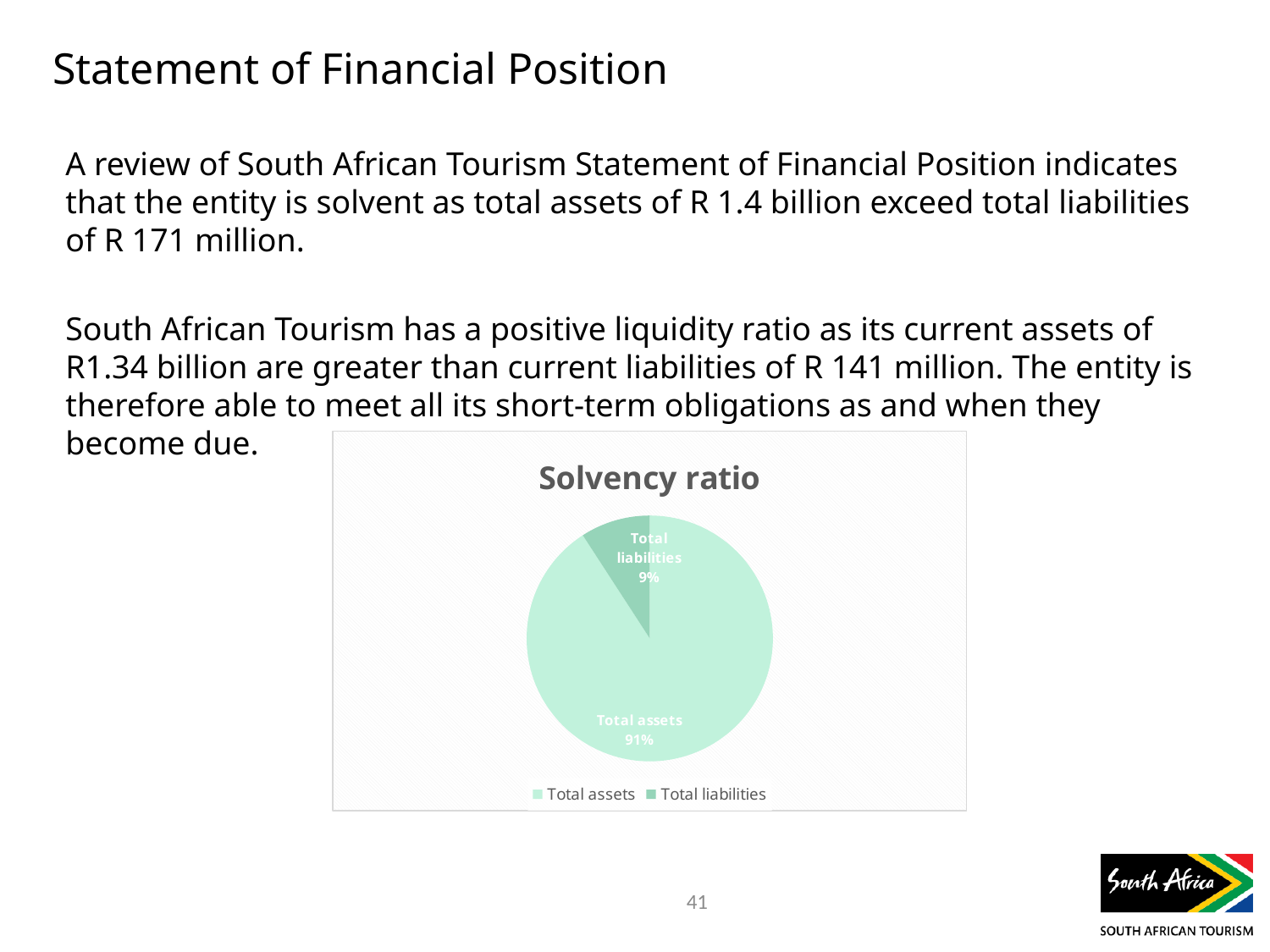
What is the combined share of the Total assets and Total liabilities slices? 100% How many entries does the legend list? 2 How many slices does the pie chart have? 2 Which slice of the pie is the largest? Total assets Which is larger, the Total assets slice or the Total liabilities slice? Total assets Which slice of the pie is the smallest? Total liabilities What is the title of the chart? Solvency ratio What share of the pie is Total assets? 91% What kind of chart is shown on the slide? pie chart What is the difference in percentage points between the Total assets slice and the Total liabilities slice? 82 percentage points What share of the pie is Total liabilities? 9%